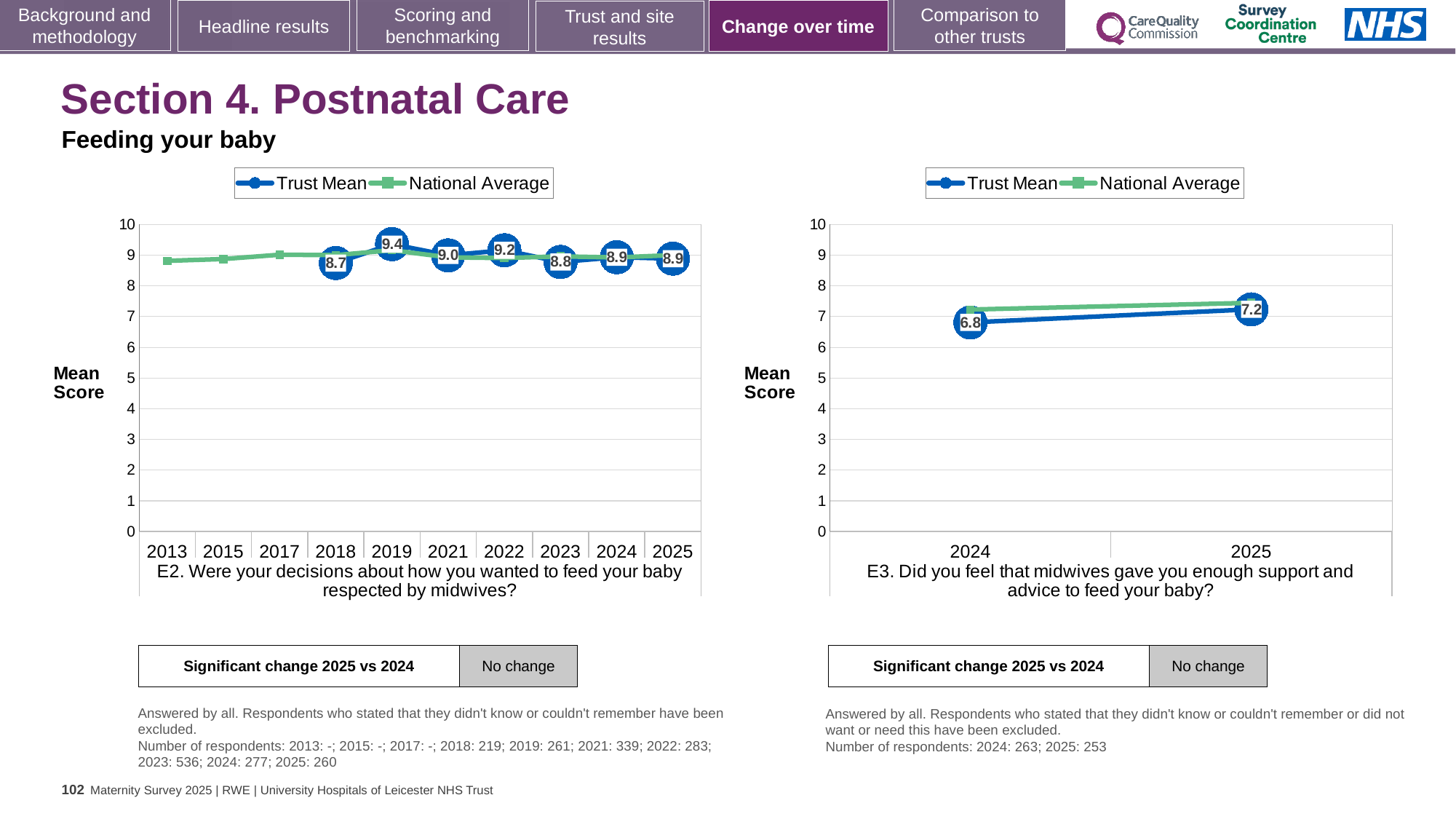
In the E2 chart on the left, which year has the lowest labelled Trust Mean? 2018 In the E2 chart on the left, which year has the highest Trust Mean? 2019 In the E2 chart on the left, what is the difference between the Trust Mean for 2019 and 2018? 0.7 In the E3 chart on the right, does the Trust Mean rise or fall from 2024 to 2025? rise In the E2 chart on the left, what is the Trust Mean for 2019? 9.4 In the E3 chart on the right, is the National Average for 2024 greater or less than 6? greater In the E3 chart on the right, what is the Trust Mean for 2024? 6.8 In the E3 chart on the right, what is the difference between the Trust Mean for 2025 and 2024? 0.4 In the E2 chart on the left, what is the Trust Mean for 2025? 8.9 In the E2 chart on the left, is the Trust Mean for 2022 higher or lower than for 2023? higher In the E2 chart on the left, how many years are shown on the x axis? 10 How many series does the legend of the E3 chart on the right list? 2